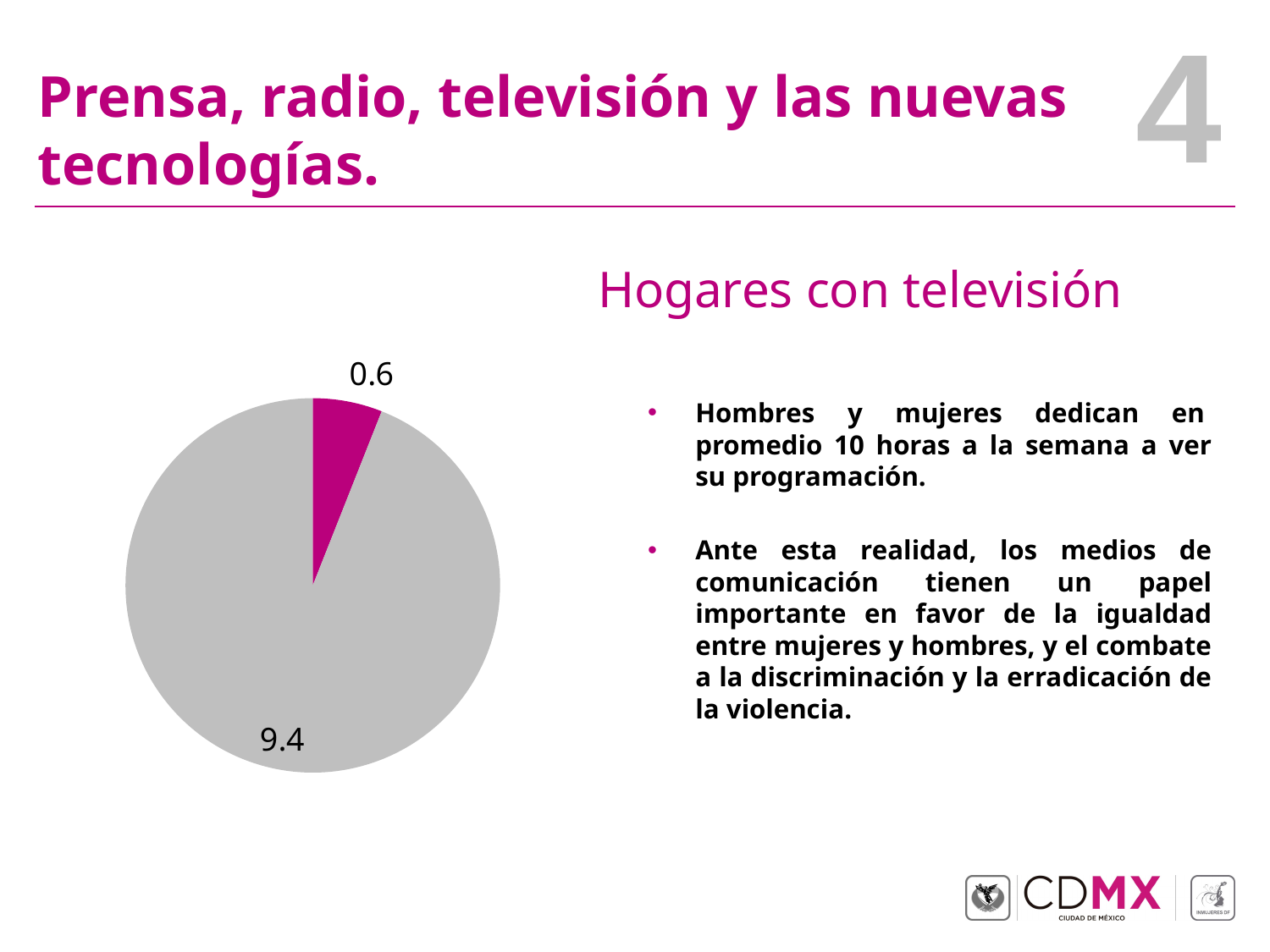
What kind of chart is shown on the slide? pie chart What is the difference between the two values shown in the pie chart, 9.4 and 0.6? 8.8 What is the value of the gray slice in the pie chart? 9.4 What share of the pie does the gray slice (9.4) represent? 94% What is the title shown above the pie chart? Hogares con televisión How many slices does the pie chart have? 2 Which slice of the pie chart has the largest value? the gray slice (9.4) Which is larger in the pie chart, the gray slice or the magenta slice? the gray slice What is the value of the magenta slice in the pie chart? 0.6 Which slice of the pie chart has the smallest value? the magenta slice (0.6) What is the total of the two values shown in the pie chart? 10 What share of the pie does the magenta slice (0.6) represent? 6%